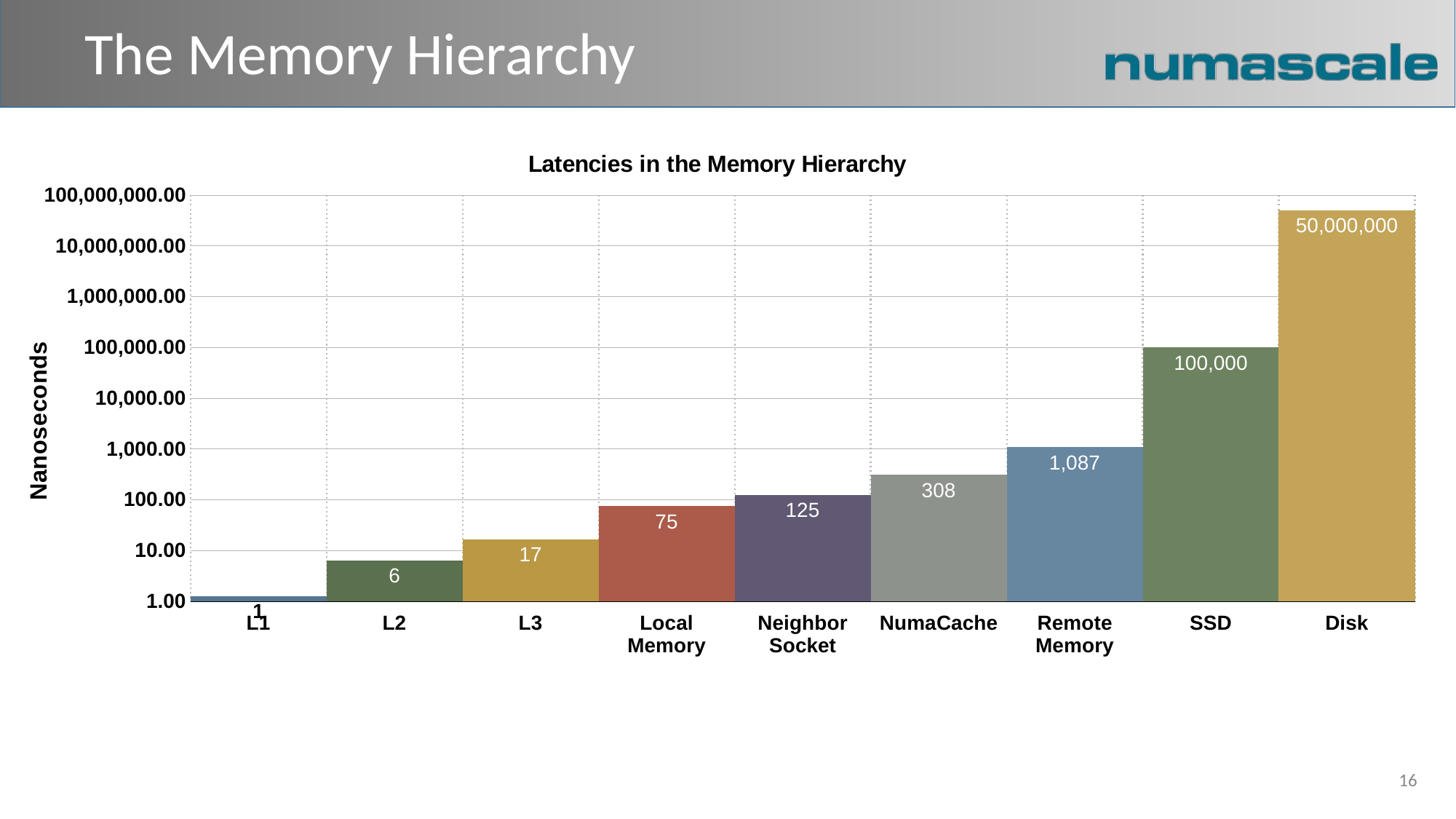
What is the latency value shown for Remote Memory? 1,087 What is the difference between the latency of Remote Memory and Local Memory? 1,012 What is the latency value shown for SSD? 100,000 Which has a higher latency, L3 or L2? L3 What kind of chart is shown on the slide? Bar chart What is the latency value shown for Neighbor Socket? 125 How many categories are shown on the x axis? 9 Do the latency values rise or fall moving from L1 to Disk along the x axis? Rise What is the title of the chart? Latencies in the Memory Hierarchy Which category has the highest latency? Disk What is the latency value shown for NumaCache? 308 Which category has the lowest latency? L1